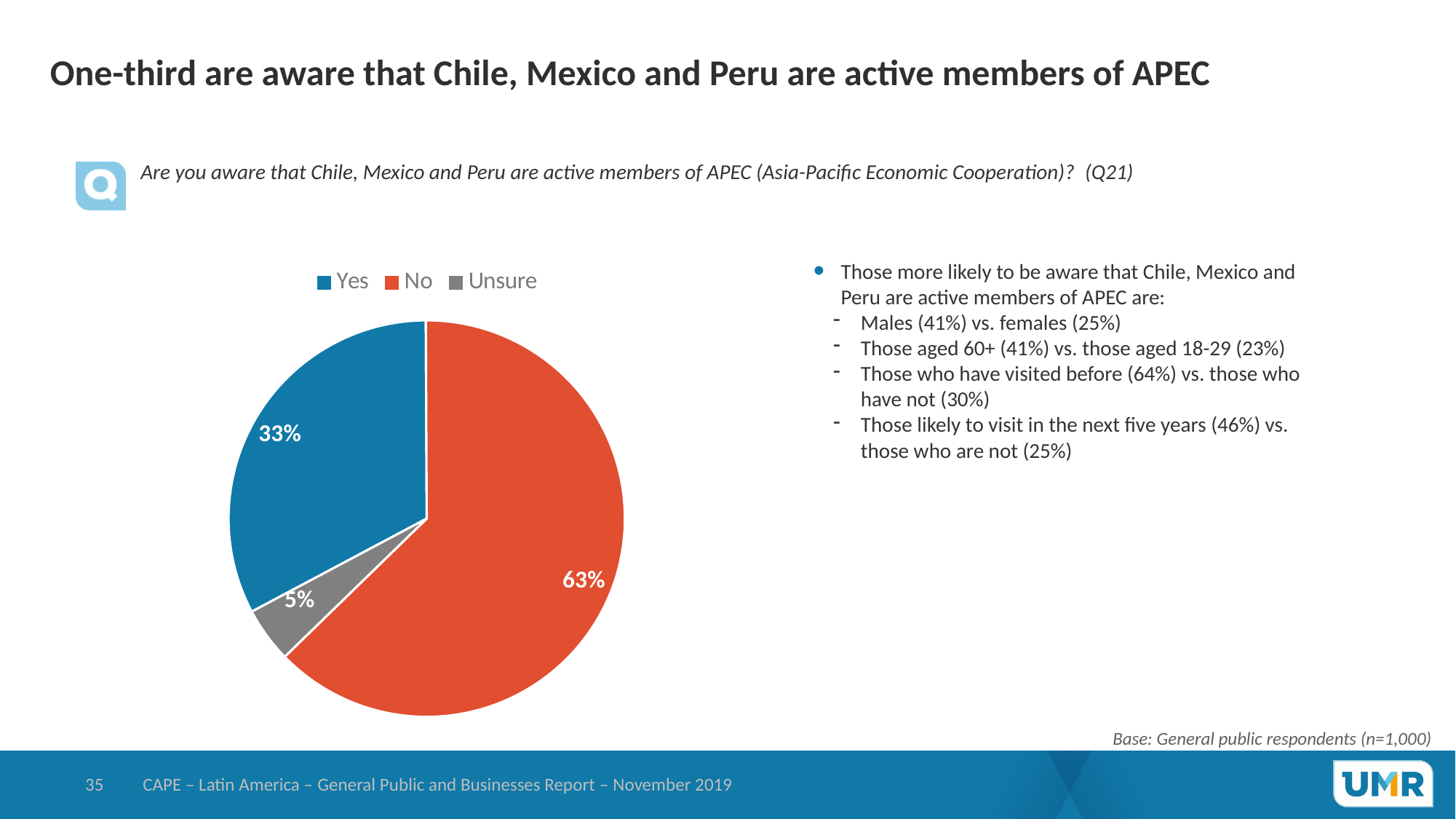
What percentage of respondents answered Unsure? 5% Which response has the largest share of the pie? No What is the difference in percentage points between the No and Yes slices? 30 What percentage of respondents answered Yes? 33% Which legend entry is shown in grey? Unsure How many entries does the legend list? 3 Which response has the smallest share of the pie? Unsure What percentage of respondents answered No? 63% What colour is the No slice? Red Which slice is larger, Yes or Unsure? Yes What kind of chart is shown on the slide? Pie chart How many slices does the pie chart have? 3